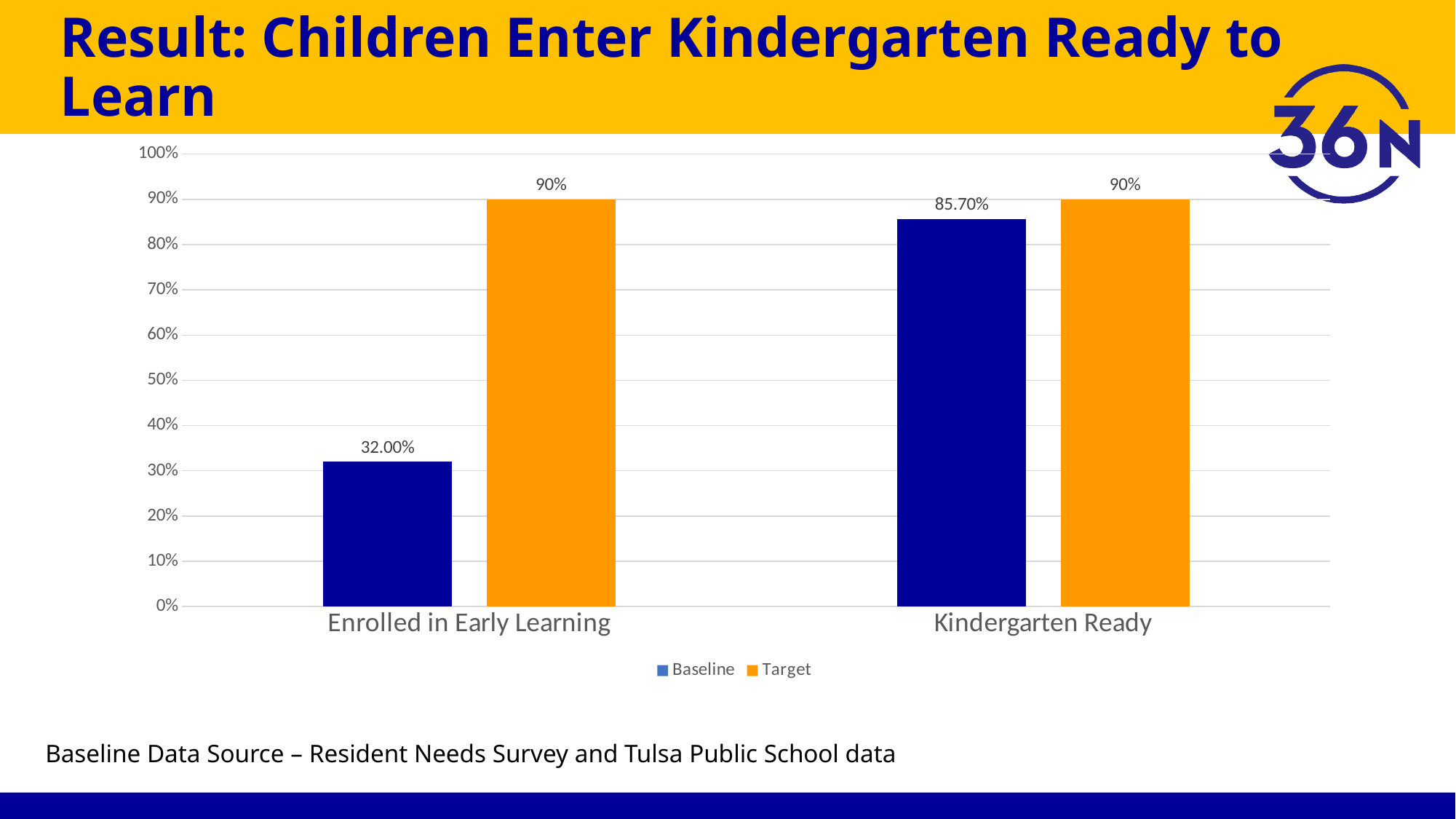
Is the Baseline value for Enrolled in Early Learning greater or less than 40%? less What is the Target value for Kindergarten Ready? 90% What kind of chart is shown on the slide? bar chart How many categories are shown on the x axis? 2 What is the Target value for Enrolled in Early Learning? 90% Which category has the highest Baseline value? Kindergarten Ready What is the Baseline value for Kindergarten Ready? 85.70% Is the Baseline value for Kindergarten Ready larger or smaller than its Target value? smaller What is the difference between the Target and Baseline values for Enrolled in Early Learning? 58 percentage points Which category has the lowest Baseline value? Enrolled in Early Learning How many series does the legend list? 2 What is the Baseline value for Enrolled in Early Learning? 32.00%